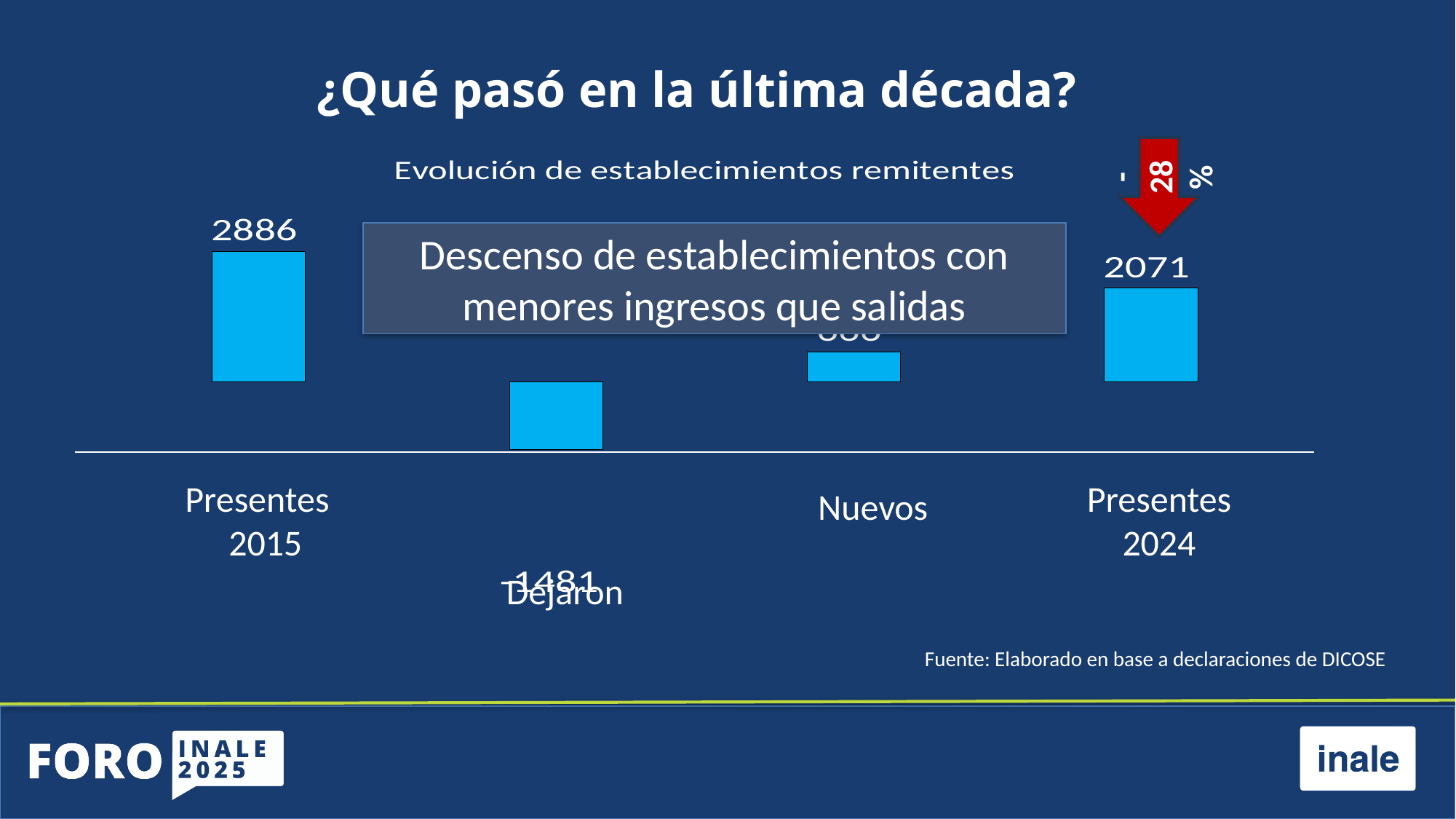
Which category's bar extends below the baseline in the chart? Dejaron What is the value for Presentes 2024 in the chart? 2071 What kind of chart is shown on the slide? Bar chart What is the title of the chart? Evolución de establecimientos remitentes What is the value shown for Dejaron in the chart? -1481 Which is larger, the value for Presentes 2015 or Presentes 2024? Presentes 2015 What percentage decrease is indicated by the red arrow next to the chart? 28 % What is the difference between the Presentes 2015 value and the Presentes 2024 value? 815 What is the value for Presentes 2015 in the chart? 2886 How many categories are shown on the x axis of the chart? 4 Which category has the highest value in the chart? Presentes 2015